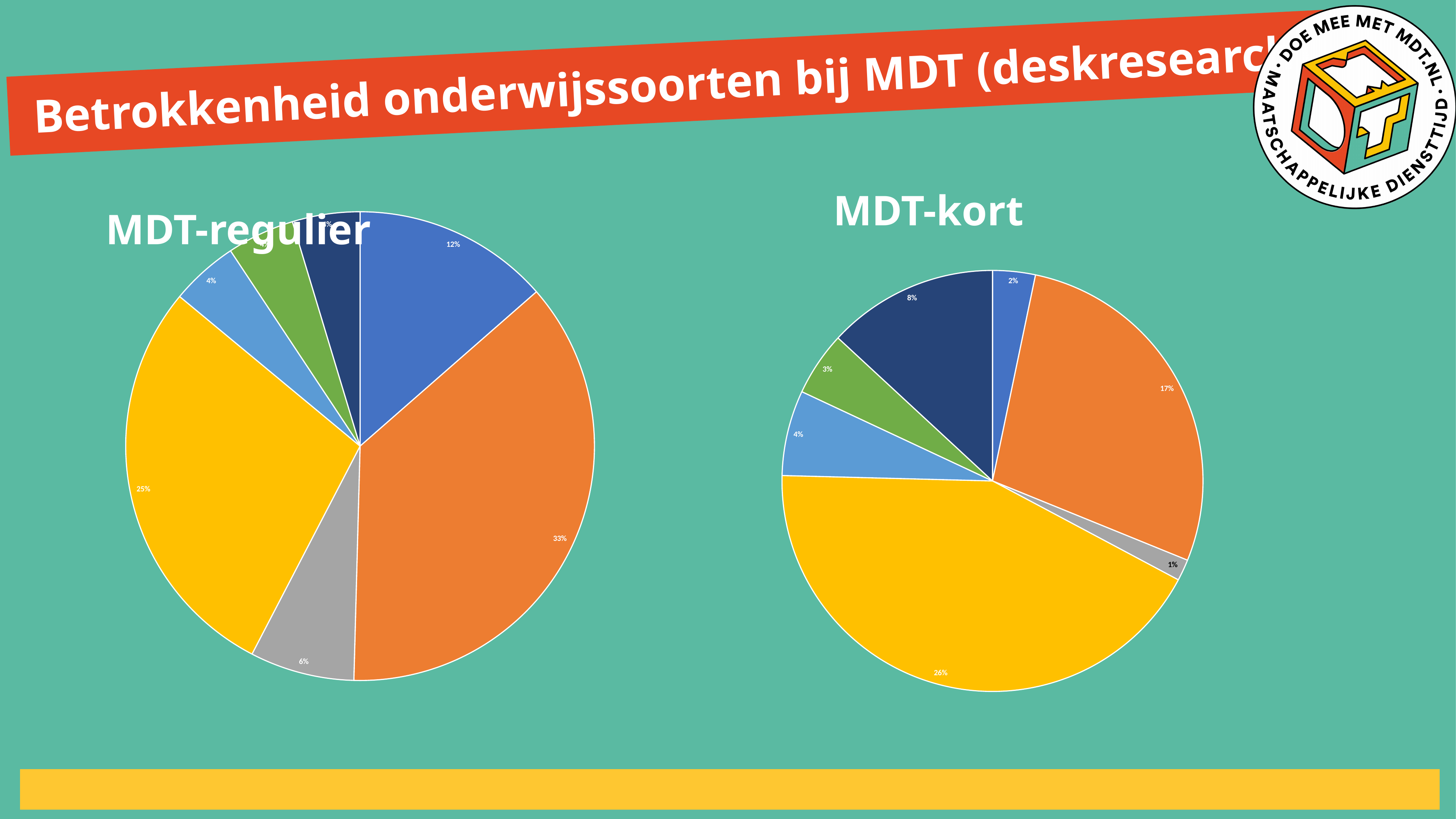
In the MDT-kort chart, what percentage is shown on the orange slice? 17% What is the difference between the orange slice in the MDT-regulier chart and the orange slice in the MDT-kort chart? 16% In the MDT-regulier chart, which is larger, the orange slice or the yellow slice? The orange slice In the MDT-kort chart, which slice is the largest? The yellow slice (26%) In the MDT-kort chart, what percentage is shown on the dark navy slice? 8% In the MDT-kort chart, what percentage is shown on the yellow slice? 26% What kind of charts are shown on the slide? Pie charts In the MDT-regulier chart, what percentage is shown on the blue slice at the top right? 12% In the MDT-kort chart, what percentage is shown on the grey slice? 1% In the MDT-regulier chart, what percentage is shown on the grey slice? 6% In the MDT-regulier chart, what percentage is shown on the yellow slice? 25% In the MDT-regulier chart, what percentage is shown on the orange slice? 33%